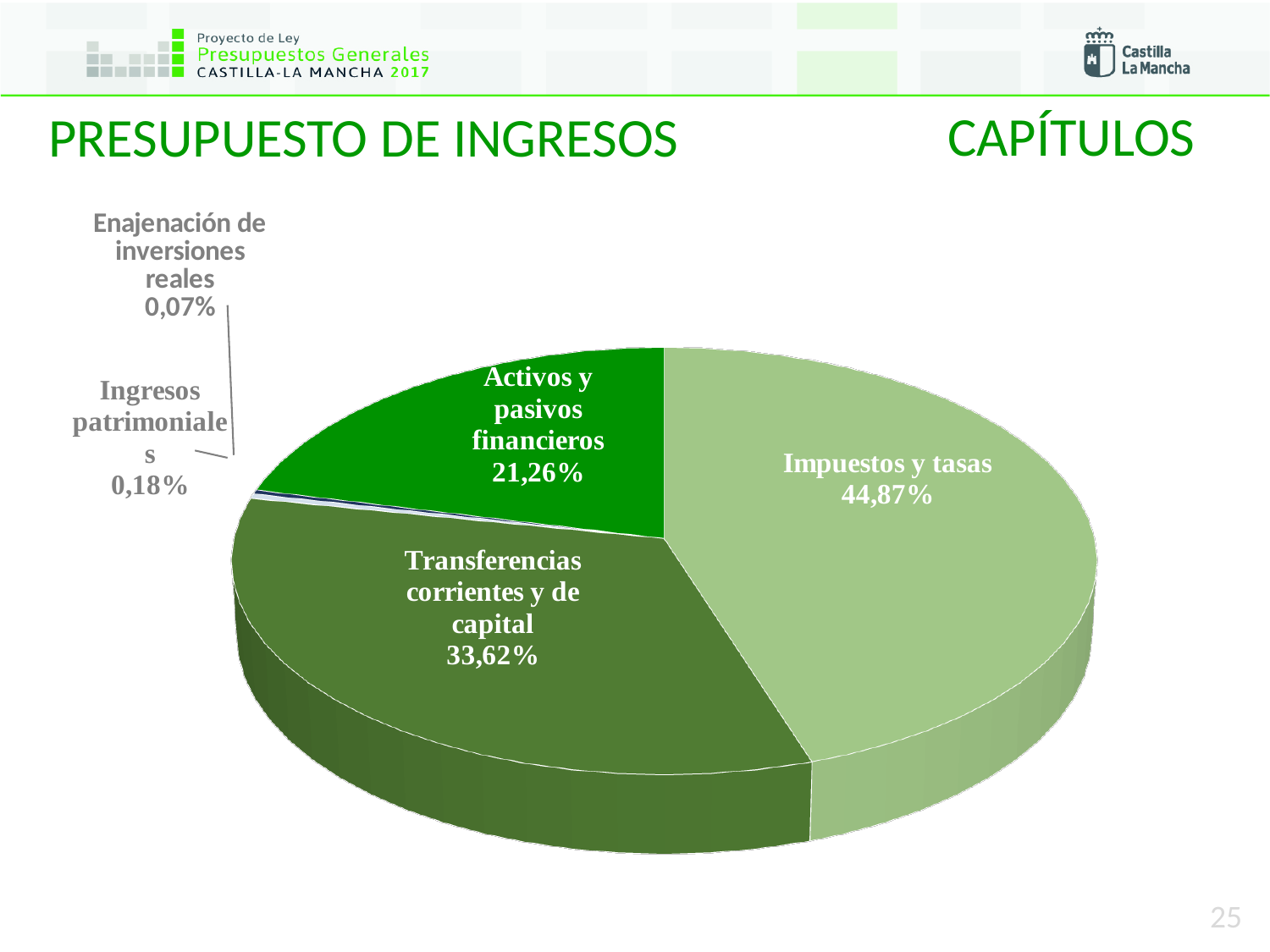
What is the combined share of Impuestos y tasas and Activos y pasivos financieros? 66,13% What share of the pie does Impuestos y tasas represent? 44,87% What is the value shown for Enajenación de inversiones reales? 0,07% How many categories are shown in the pie chart? 5 Which is larger, Transferencias corrientes y de capital or Activos y pasivos financieros? Transferencias corrientes y de capital What percentage is shown for Activos y pasivos financieros? 21,26% What is the difference in percentage points between Impuestos y tasas and Transferencias corrientes y de capital? 11,25 What is the value shown for Transferencias corrientes y de capital? 33,62% What is the value shown for Ingresos patrimoniales? 0,18% Which category has the smallest share of the pie? Enajenación de inversiones reales Which category has the largest share of the pie? Impuestos y tasas What kind of chart is shown on the slide? Pie chart